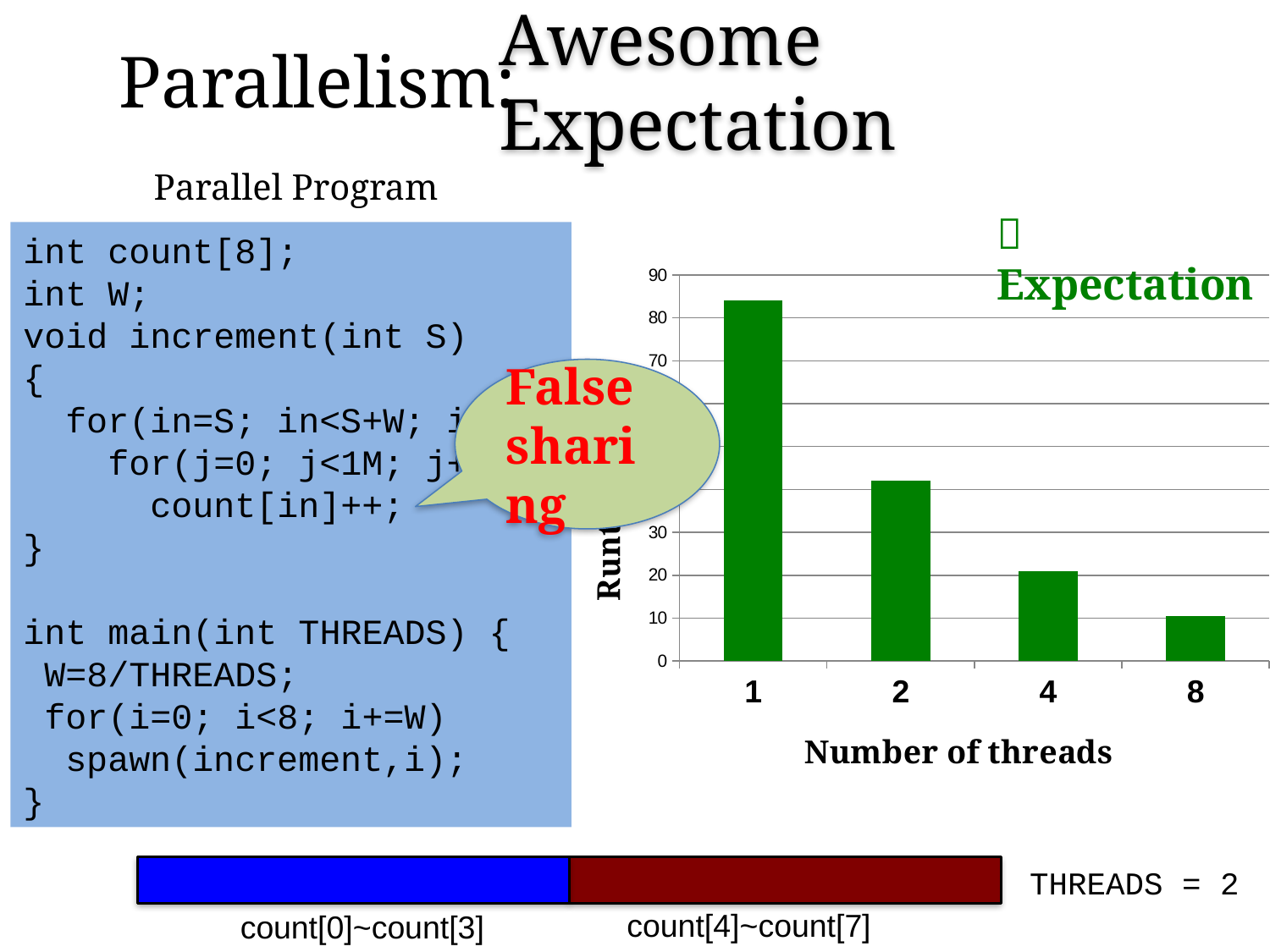
What is the label of the x axis of the chart? Number of threads Is the value for 2 threads greater or less than 50? less Do the values rise or fall as the number of threads increases along the x axis? fall What kind of chart is shown on the slide? bar chart Which number of threads has the highest bar in the chart? 1 Is the value for 4 threads greater or less than 30? less Is the value for 8 threads greater or less than 20? less Which is larger in the chart, the value for 2 threads or the value for 4 threads? 2 threads Which number of threads has the lowest bar in the chart? 8 How many categories are plotted along the x axis of the chart? 4